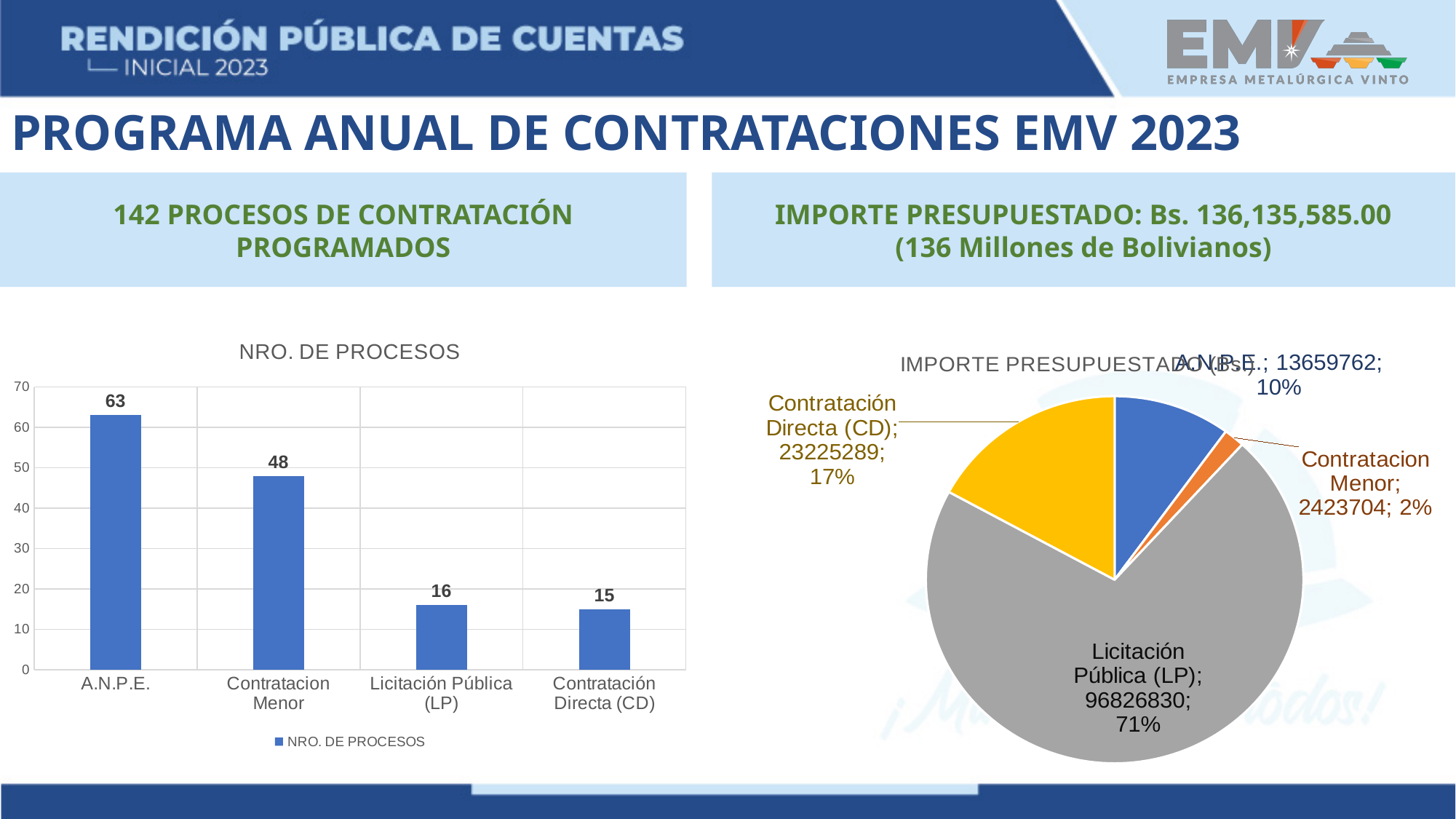
In the 'NRO. DE PROCESOS' bar chart, what is the value for A.N.P.E.? 63 In the 'NRO. DE PROCESOS' bar chart, do the values rise or fall from left to right? fall In the 'NRO. DE PROCESOS' bar chart, what is the value for Contratación Directa (CD)? 15 In the 'NRO. DE PROCESOS' bar chart, which category has the highest value? A.N.P.E. In the 'NRO. DE PROCESOS' bar chart, which category has the lowest value? Contratación Directa (CD) In the 'IMPORTE PRESUPUESTADO (Bs.)' pie chart, which slice is the smallest? Contratacion Menor What kind of chart is the 'NRO. DE PROCESOS' chart? bar chart In the 'IMPORTE PRESUPUESTADO (Bs.)' pie chart, what share does Licitación Pública (LP) have? 71% In the 'IMPORTE PRESUPUESTADO (Bs.)' pie chart, which is larger: A.N.P.E. or Contratación Directa (CD)? Contratación Directa (CD) In the 'IMPORTE PRESUPUESTADO (Bs.)' pie chart, what is the value for Contratación Directa (CD)? 23225289 In the 'NRO. DE PROCESOS' bar chart, how many categories are shown? 4 In the 'NRO. DE PROCESOS' bar chart, what is the difference between A.N.P.E. and Contratacion Menor? 15